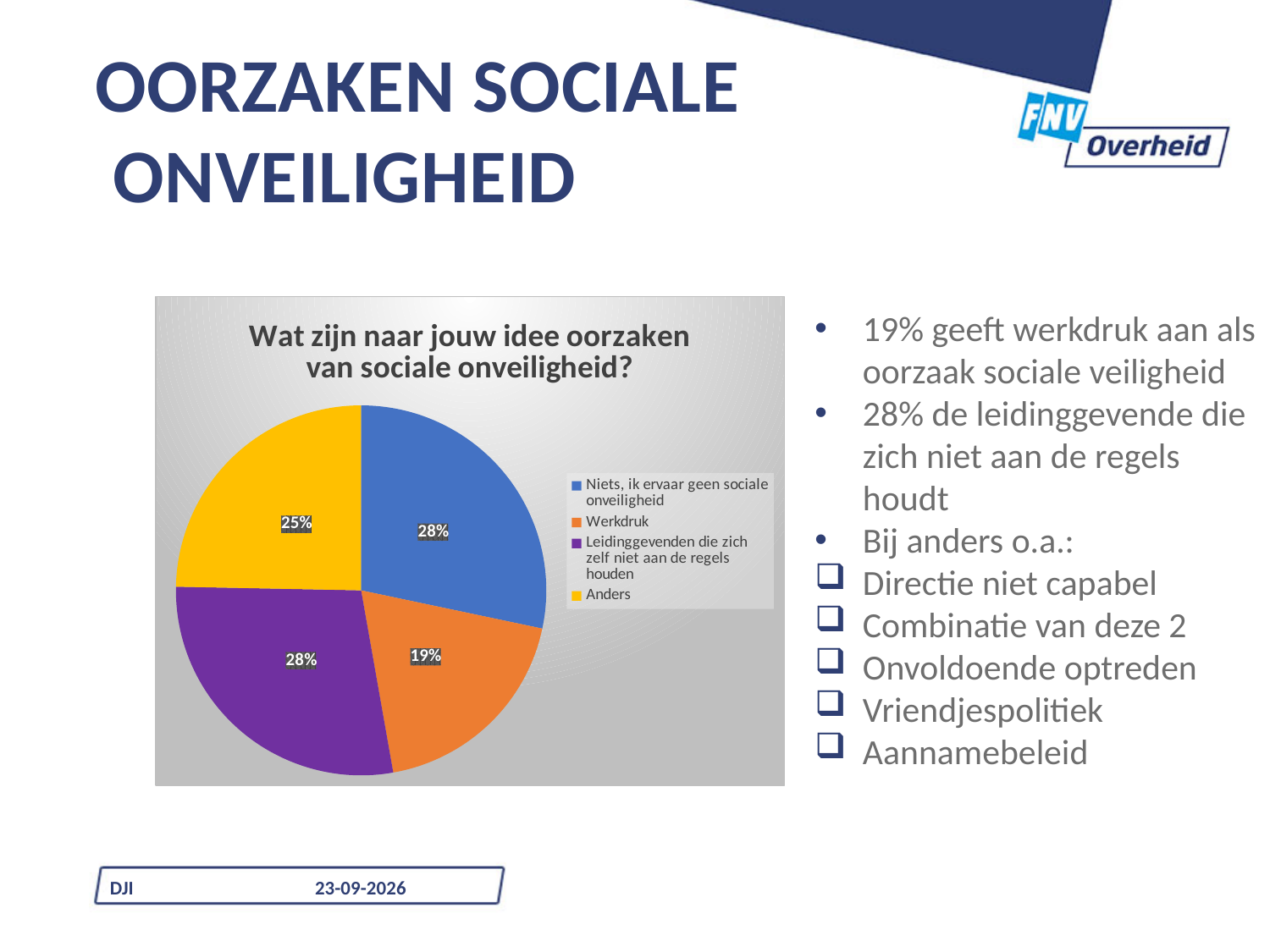
Which colour represents 'Anders' in the pie chart? yellow How many slices does the pie chart have? 4 What kind of chart is shown on the slide? pie chart Which is larger: the slice for 'Anders' or the slice for 'Werkdruk'? Anders What is the difference in percentage points between the 'Anders' slice and the 'Werkdruk' slice? 6 What share of the pie is labelled 'Anders'? 25% What is the title of the pie chart? Wat zijn naar jouw idee oorzaken van sociale onveiligheid? What share of the pie is labelled 'Werkdruk'? 19% What share of the pie is labelled 'Niets, ik ervaar geen sociale onveiligheid'? 28% What is the difference in percentage points between the 'Niets, ik ervaar geen sociale onveiligheid' slice and the 'Werkdruk' slice? 9 Which category has the smallest slice of the pie? Werkdruk